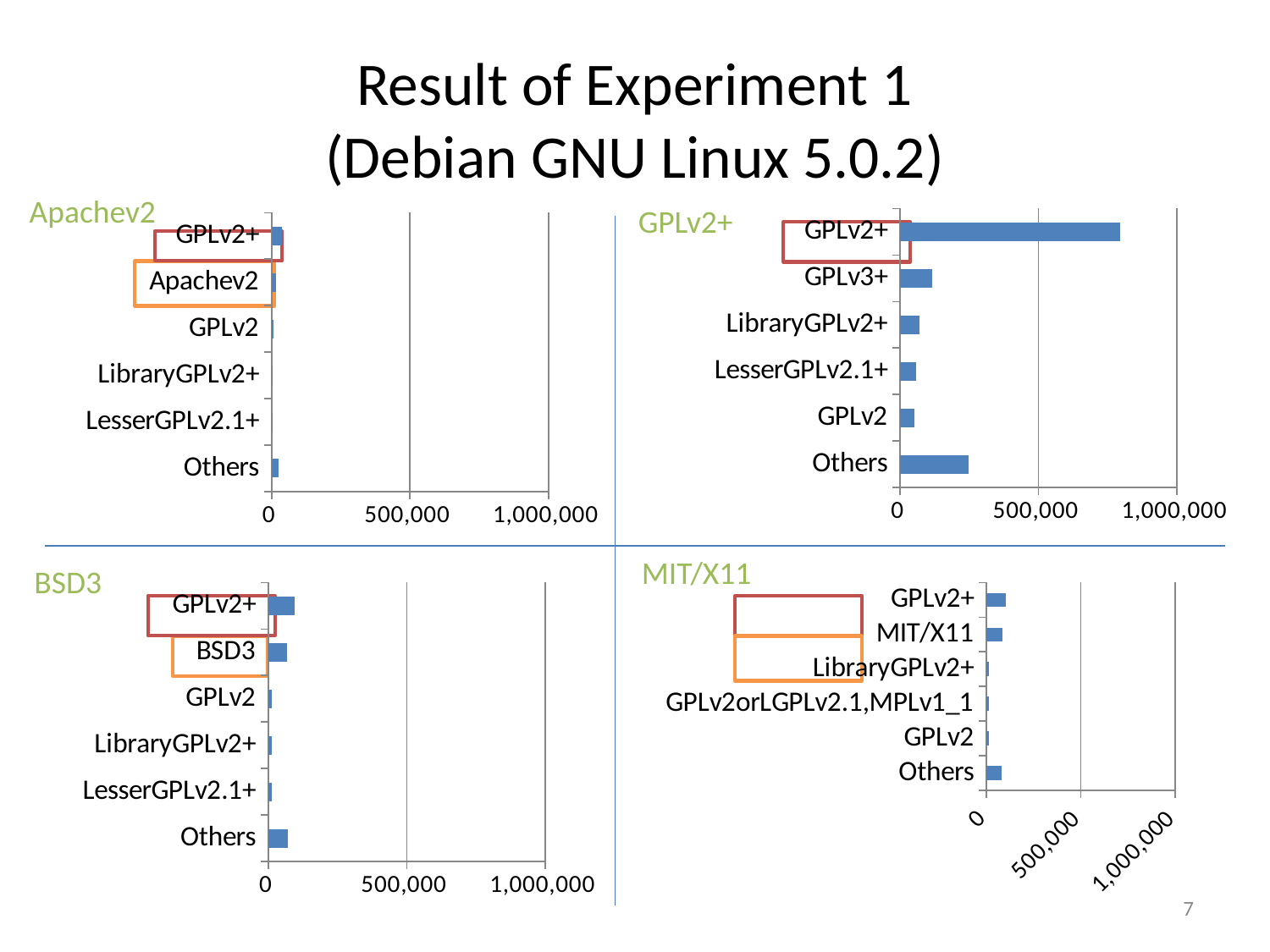
What kind of chart is the GPLv2+ chart in the top right? bar chart In the GPLv2+ chart, is the value for Others greater or less than 500,000? less In the Apachev2 chart, is the value for Apachev2 greater or less than 500,000? less In the BSD3 chart, which category has the longest bar? GPLv2+ How many categories are listed in the Apachev2 chart? 6 In the GPLv2+ chart, which is larger, GPLv3+ or Others? Others How many charts are shown on the slide? 4 In the GPLv2+ chart, is the value for GPLv2+ greater or less than 500,000? greater How many categories are listed in the MIT/X11 chart? 6 In the GPLv2+ chart, which category has the longest bar? GPLv2+ What is the label of the chart in the bottom-right quadrant of the slide? MIT/X11